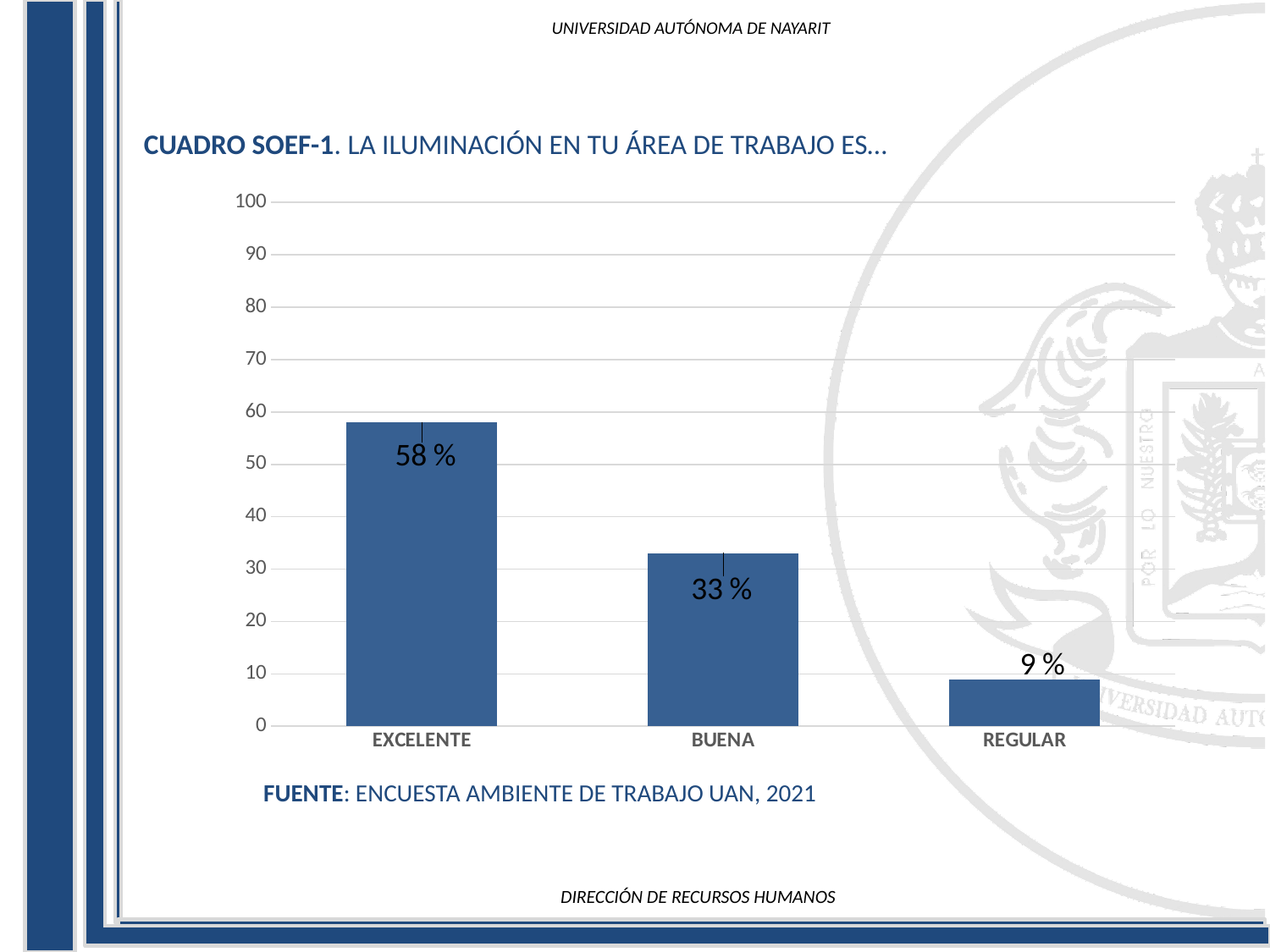
Which category has the highest value? EXCELENTE How many categories are shown on the x axis? 3 Which category has the lowest value? REGULAR What is the value for BUENA? 33 % What is the difference between the values for BUENA and REGULAR? 24 % What is the value for REGULAR? 9 % What is the value for EXCELENTE? 58 % Is the value for EXCELENTE greater or less than 50? greater What is the difference between the values for EXCELENTE and BUENA? 25 % Which is larger, the value for BUENA or the value for REGULAR? BUENA What kind of chart is shown on the slide? bar chart Do the values rise or fall from left to right along the x axis? fall